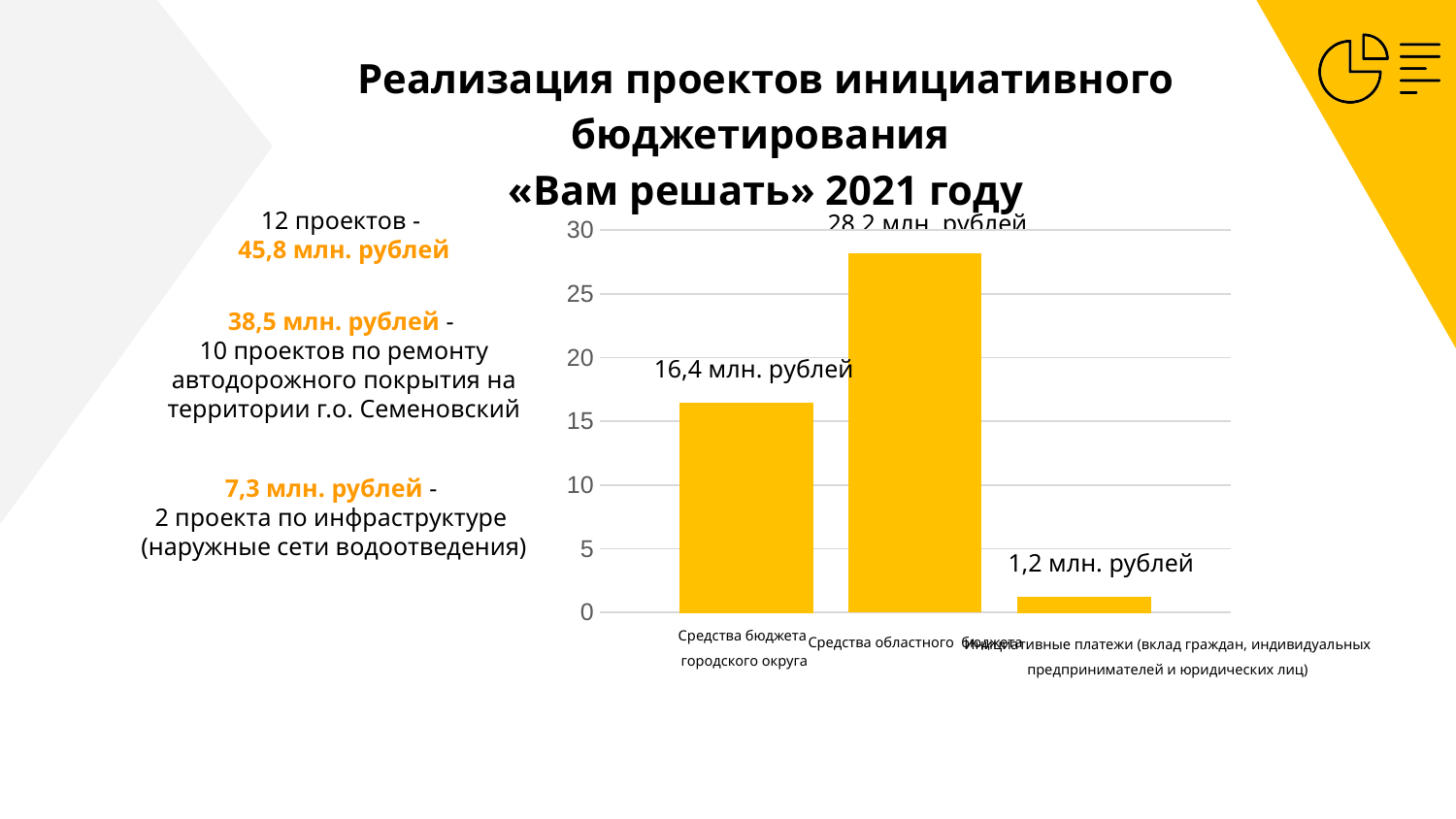
Which is larger: Средства бюджета городского округа or Средства областного бюджета? Средства областного бюджета What value is shown for Средства областного бюджета? 28,2 млн. рублей What value is shown for Инициативные платежи (вклад граждан, индивидуальных предпринимателей и юридических лиц)? 1,2 млн. рублей Which category has the lowest value? Инициативные платежи (вклад граждан, индивидуальных предпринимателей и юридических лиц) What is the difference between Средства областного бюджета and Средства бюджета городского округа? 11,8 млн. рублей How many categories are shown in the chart? 3 What kind of chart is shown on the slide? bar chart What value is shown for Средства бюджета городского округа? 16,4 млн. рублей Is the value for Средства областного бюджета greater or less than 25? greater What is the difference between Средства бюджета городского округа and Инициативные платежи? 15,2 млн. рублей Which category has the highest value? Средства областного бюджета Is the value for Средства бюджета городского округа greater or less than 20? less